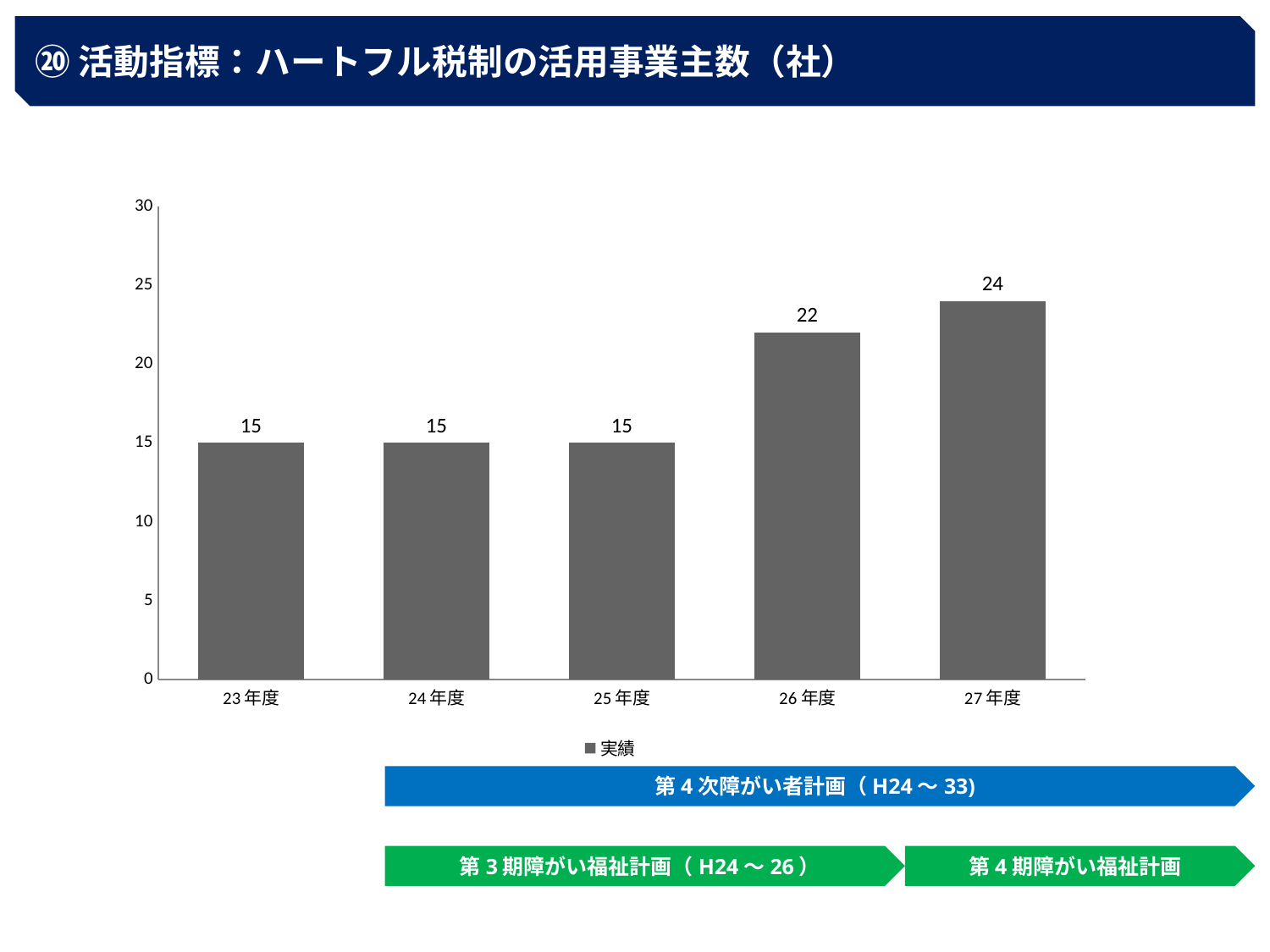
Which is larger, the value for 26年度 or the value for 24年度? 26年度 Do the values rise or fall from 23年度 to 27年度? rise What is the difference between the values for 27年度 and 26年度? 2 Is the value for 27年度 greater or less than 20? greater Which year has the highest value? 27年度 How many years are shown on the x axis? 5 What is the difference between the values for 26年度 and 25年度? 7 What is the value for 26年度? 22 What is the value for 27年度? 24 What kind of chart is shown? bar chart How many series does the legend list? 1 What is the value for 23年度? 15